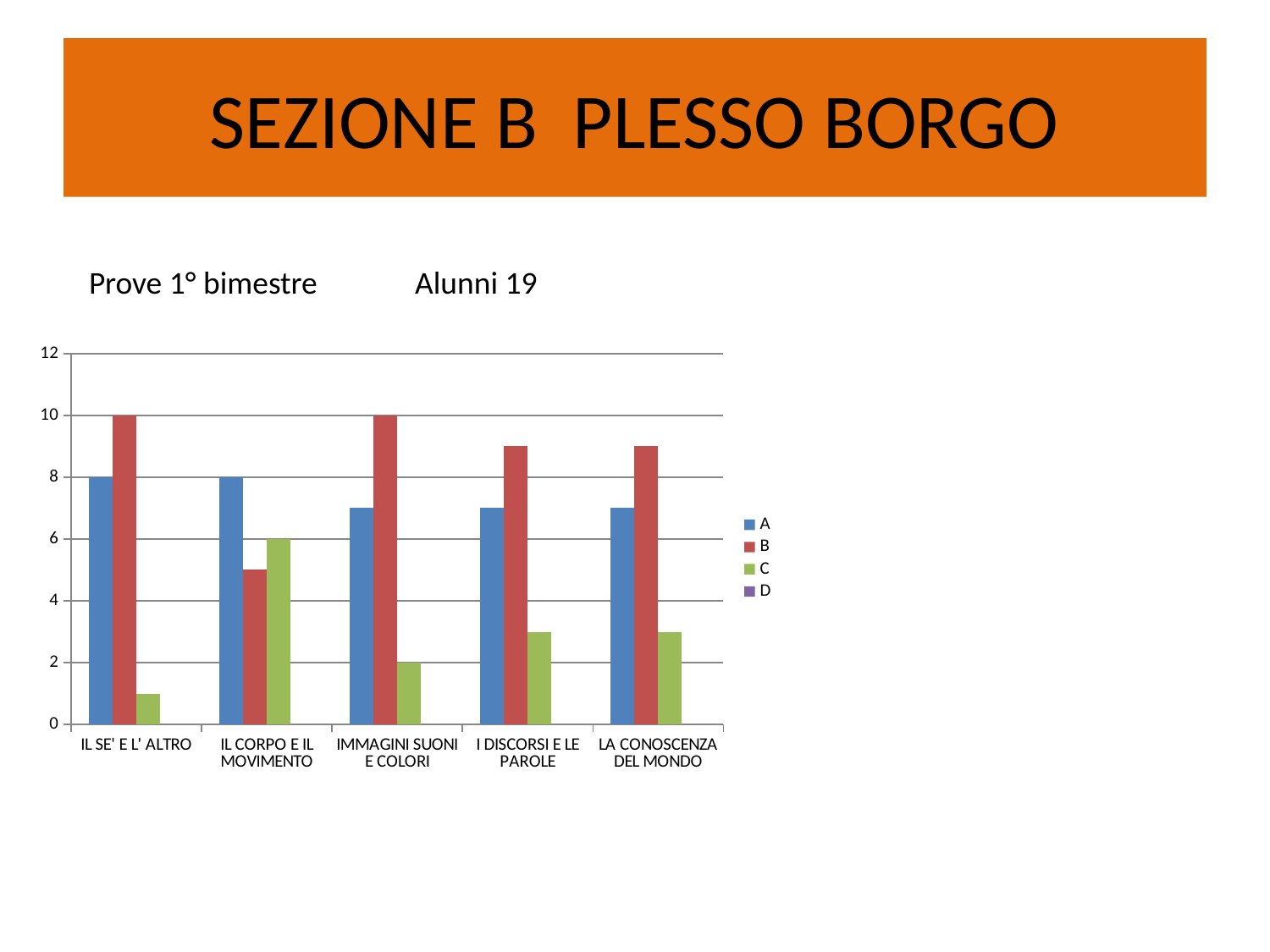
What kind of chart is shown on the slide? bar chart How many categories are shown on the x axis? 5 Is the value of series B for I DISCORSI E LE PAROLE greater or less than 8? greater What is the difference between series B and series A for IL SE' E L' ALTRO? 2 How many series does the legend list? 4 Is the value of series C for IL SE' E L' ALTRO greater or less than 2? less What is the value of series C for IMMAGINI SUONI E COLORI? 2 What is the value of series A for IL SE' E L' ALTRO? 8 What is the value of series C for IL CORPO E IL MOVIMENTO? 6 What is the value of series B for IMMAGINI SUONI E COLORI? 10 Which category has the highest value for series C? IL CORPO E IL MOVIMENTO For IL CORPO E IL MOVIMENTO, which is larger, series A or series B? A